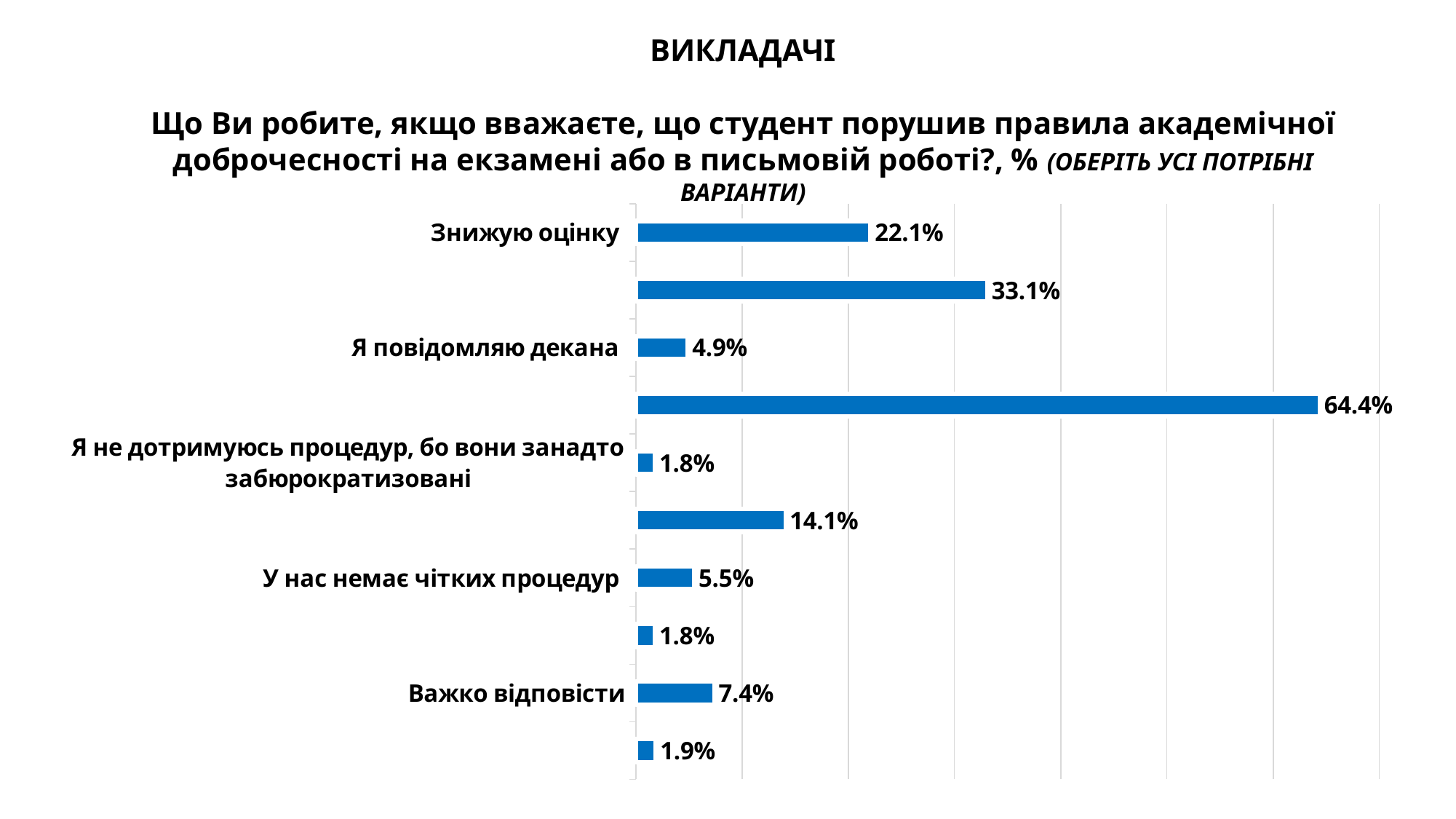
Which is larger: the value for "Важко відповісти" or the value for "У нас немає чітких процедур"? Важко відповісти What is the value for "У нас немає чітких процедур"? 5.5% What is the value for "Я не дотримуюсь процедур, бо вони занадто забюрократизовані"? 1.8% What is the value for "Важко відповісти"? 7.4% What is the value for "Я повідомляю декана"? 4.9% What is the difference between the values for "Знижую оцінку" and "Я повідомляю декана"? 17.2 percentage points Which is larger: the value for "Знижую оцінку" or the value for "Я повідомляю декана"? Знижую оцінку What kind of chart is shown on the slide? bar chart What is the value for "Знижую оцінку"? 22.1% What is the highest value shown on the chart? 64.4% How many bars are plotted on the chart? 10 What is the heading shown at the top of the slide above the chart title? ВИКЛАДАЧІ